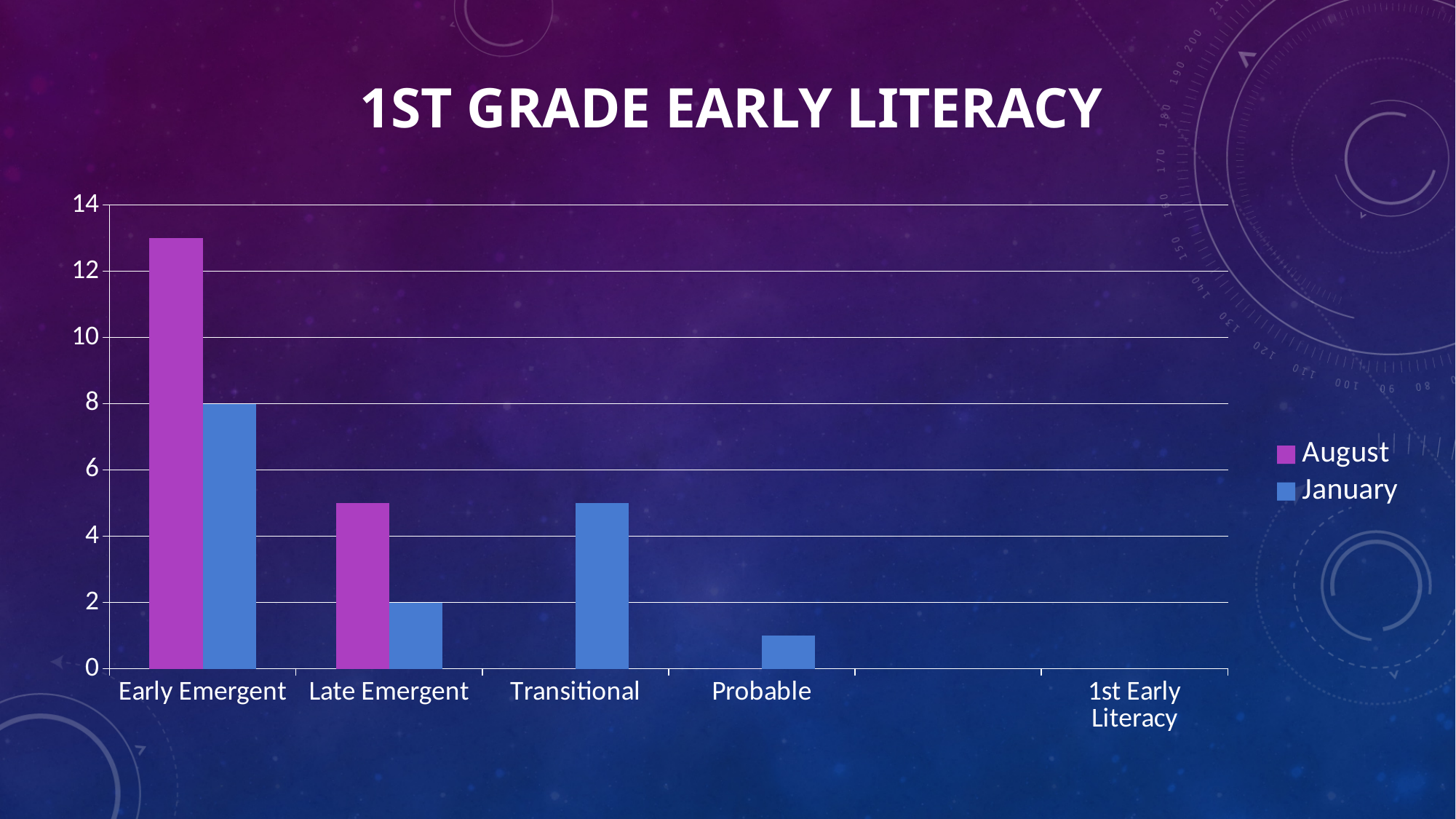
Which two series are listed in the legend? August and January Is the January value for Probable greater or less than 2? less What is the title of the chart? 1ST GRADE EARLY LITERACY For Early Emergent, which is larger, the August value or the January value? August What is the difference between the January values for Early Emergent and Late Emergent? 6 What is the January value for Late Emergent? 2 What kind of chart is shown on the slide? bar chart What is the January value for Early Emergent? 8 How many series does the legend list? 2 Which category has the highest January value? Early Emergent Which category has the highest August value? Early Emergent Is the August value for Early Emergent greater or less than 12? greater